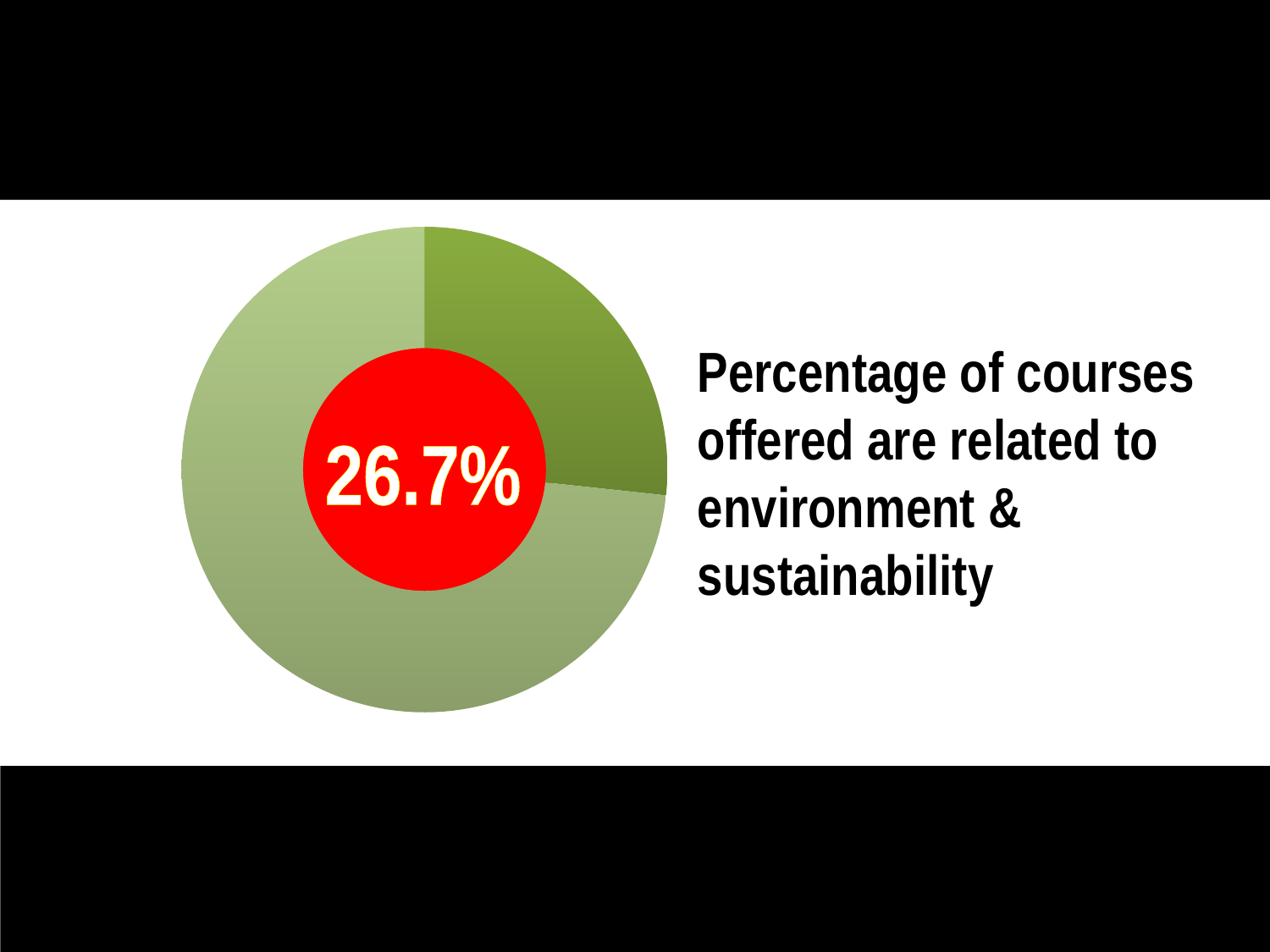
How many slices does the pie chart have? 2 Which slice of the pie is larger, the darker green slice or the lighter green slice? The lighter green slice What colour is the circle in the centre of the pie chart that displays the percentage? Red What share of the pie does the darker green slice represent? 26.7% What share of the pie does the lighter green slice represent? 73.3% What kind of chart is shown on the slide? Doughnut chart What percentage is printed in the centre of the pie chart? 26.7% According to the text beside the chart, what does the 26.7% figure represent? Percentage of courses offered are related to environment & sustainability Is the share of the darker green slice greater or less than 50%? less